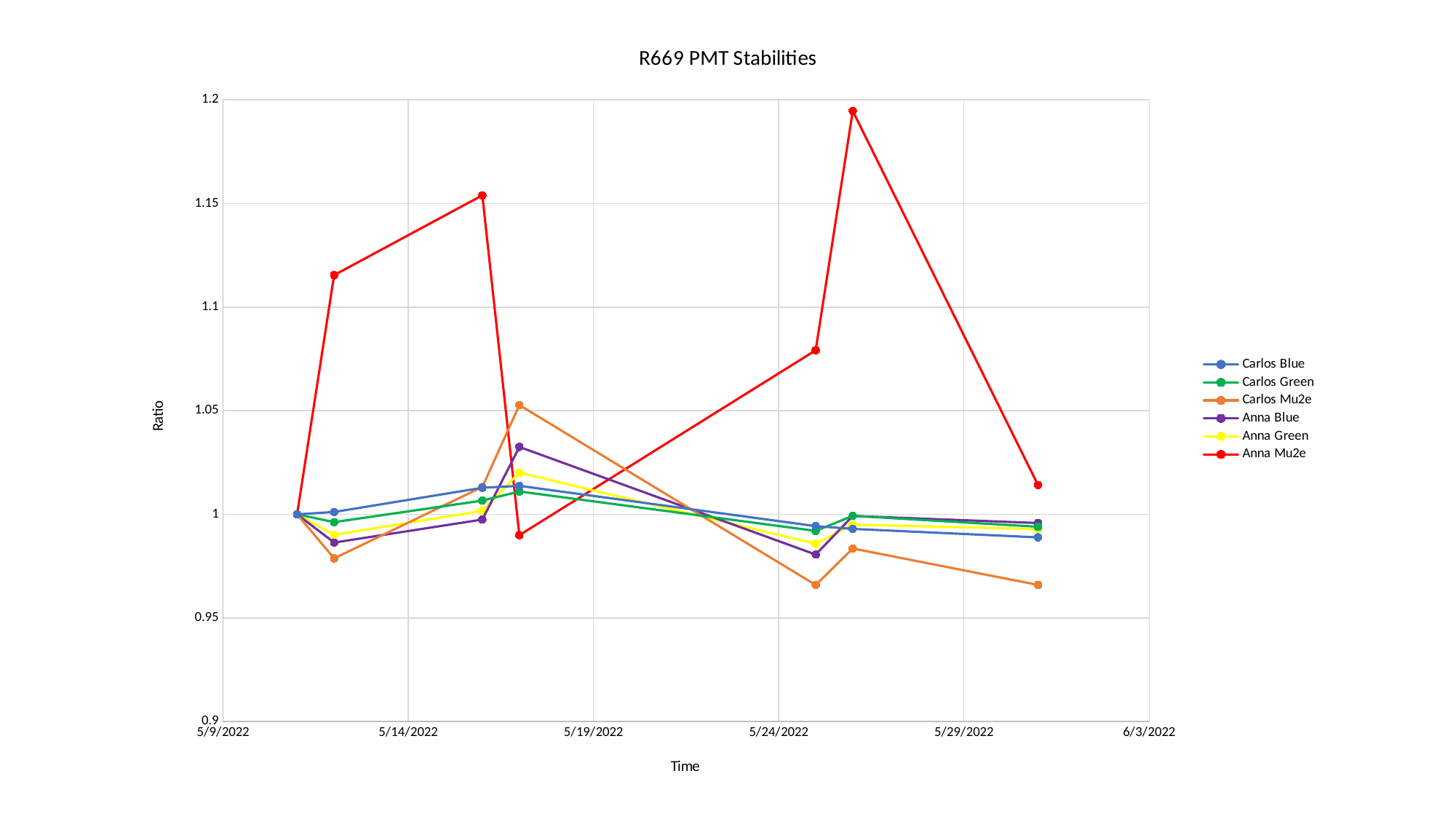
How many series does the legend list? 6 What type of chart is shown on the slide? line chart What is the label of the vertical axis? Ratio Is the highest value of the Anna Blue series greater or less than 1.05? less Which series reaches the lowest value on the chart? Carlos Mu2e At the last data point, which is larger: Carlos Blue or Carlos Mu2e? Carlos Blue Is the highest value of the Anna Mu2e series greater or less than 1.15? greater Which series reaches the highest value on the chart? Anna Mu2e Is the lowest value of the Carlos Mu2e series greater or less than 0.95? greater How many data points does the Anna Mu2e series have? 7 Does the Anna Mu2e series rise or fall between its last two data points? fall What is the title of the chart? R669 PMT Stabilities